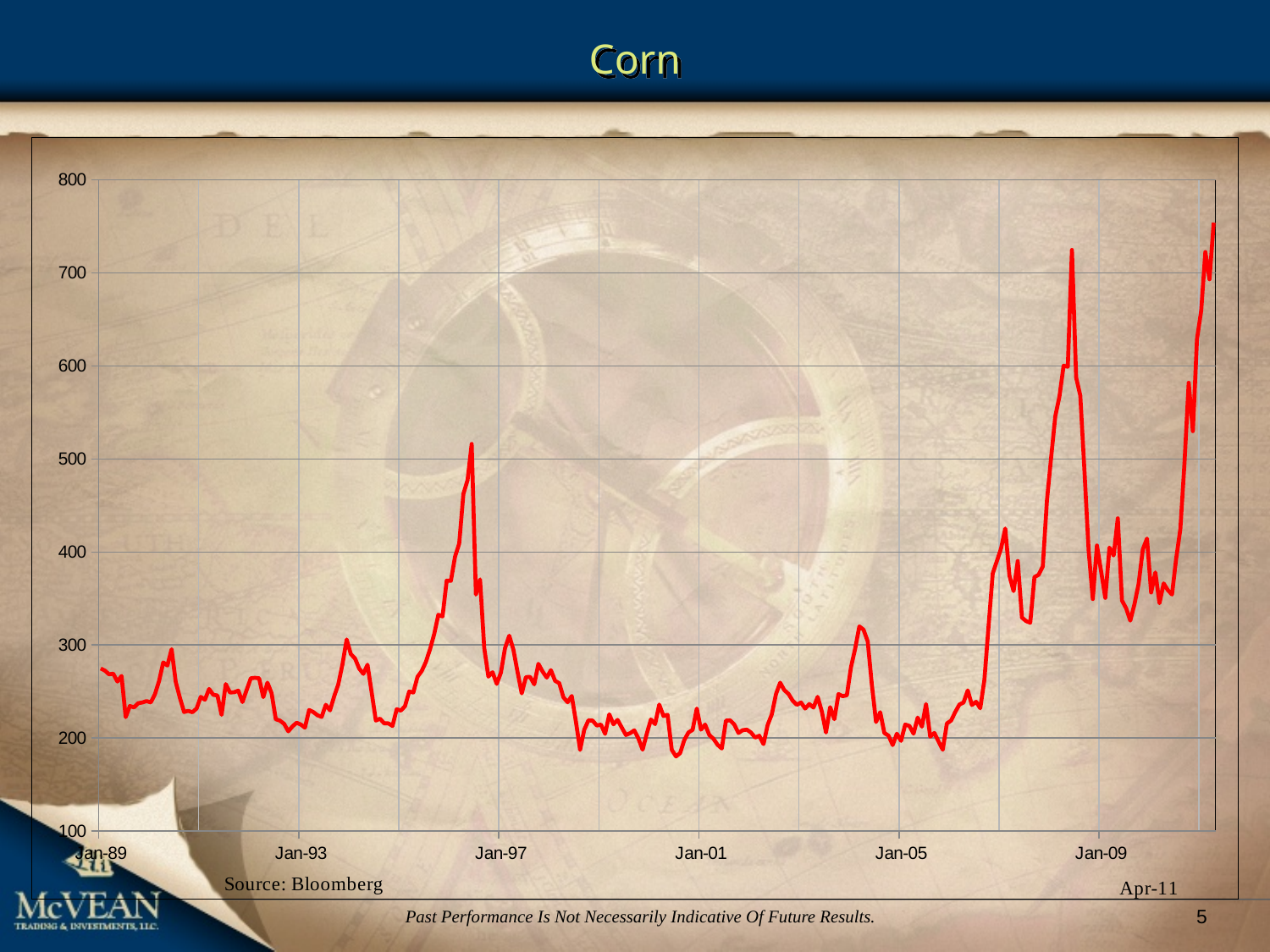
Is the value at Jan-09 greater or less than 300? greater Is the value at Jan-89 greater or less than 200? greater Is the peak reached in 2008 greater or less than 700? greater What is the title of the chart? Corn What is the highest value shown on the vertical axis? 800 What kind of chart is shown on the slide? line chart What source is cited for the chart data? Bloomberg Does the line rise or fall between Jan-09 and the end of the series? rise